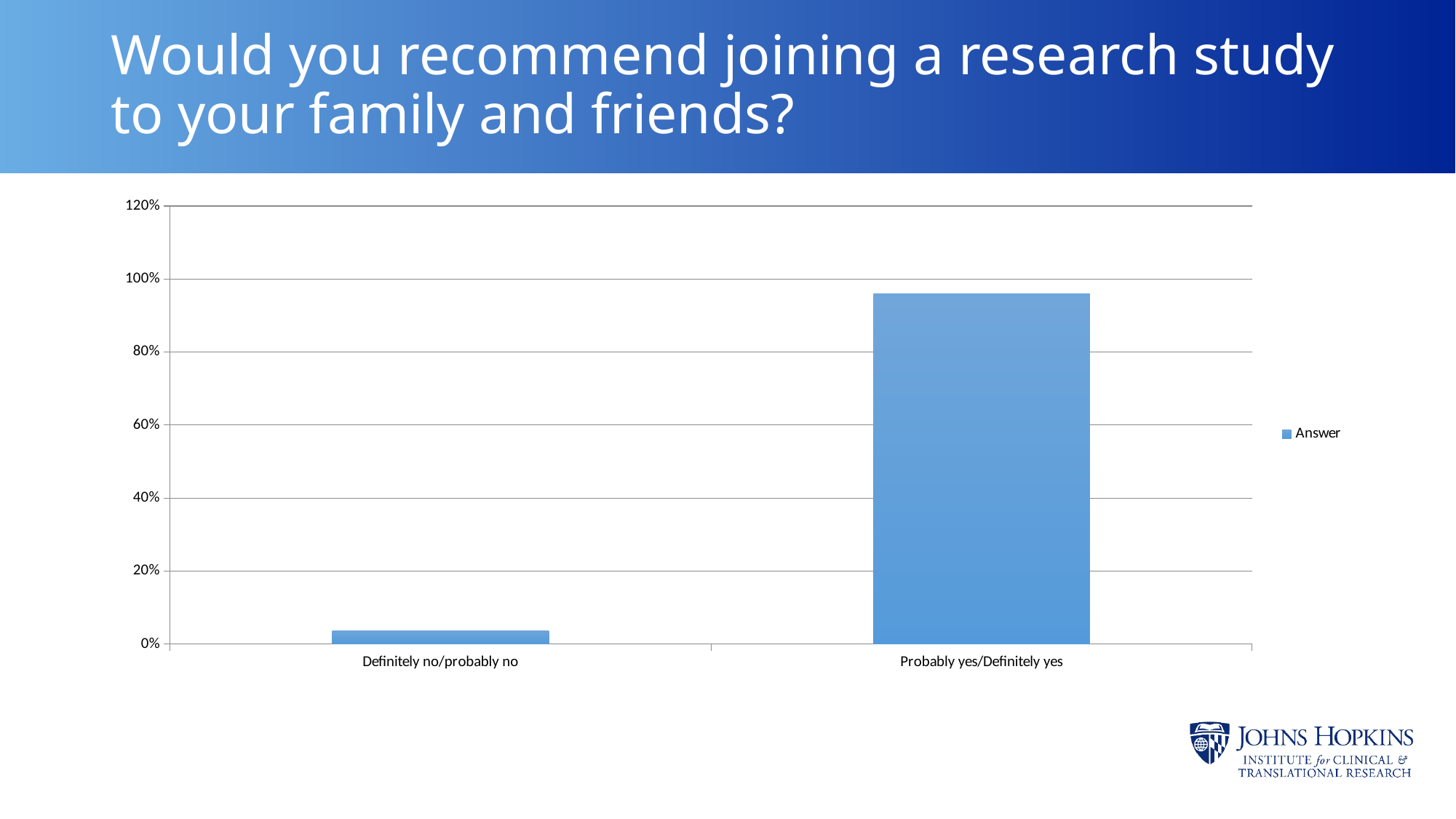
Which category has the highest value? Probably yes/Definitely yes How many categories are shown on the x axis? 2 What is the highest value shown on the y axis? 120% What is the name of the series listed in the legend? Answer What kind of chart is shown on the slide? bar chart Which is larger, the value for Definitely no/probably no or the value for Probably yes/Definitely yes? Probably yes/Definitely yes Is the value for Definitely no/probably no greater or less than 20%? less Is the value for Probably yes/Definitely yes greater or less than 100%? less How many series does the legend list? 1 Is the value for Probably yes/Definitely yes greater or less than 80%? greater Which category has the lowest value? Definitely no/probably no